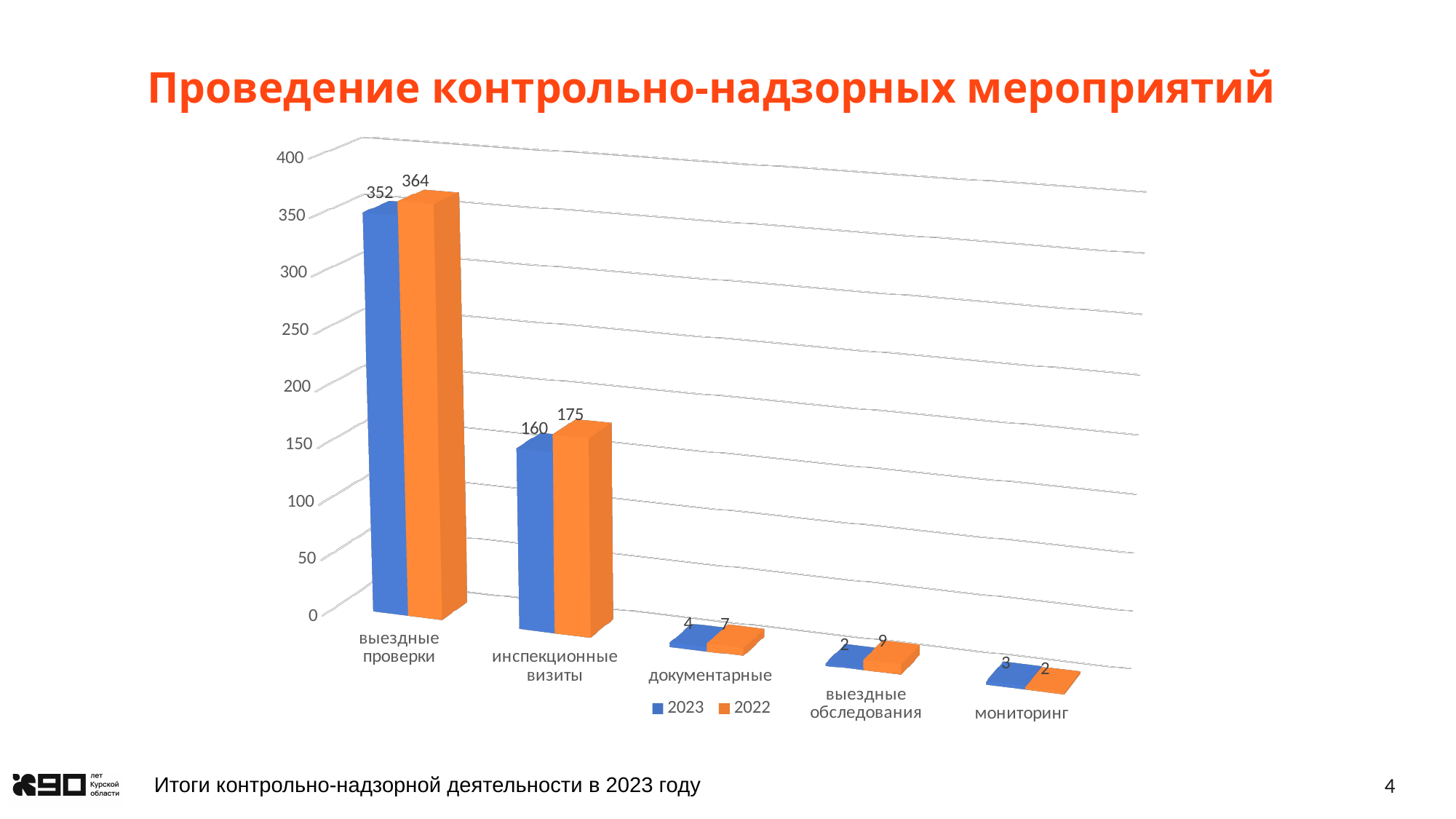
How many series does the legend list? 2 Which category has the lowest 2022 value? мониторинг What is the 2023 value for выездные проверки? 352 What is the 2023 value for мониторинг? 3 What kind of chart is shown on the slide? bar chart What is the 2022 value for выездные обследования? 9 How many categories are shown on the x axis? 5 Which category has the highest 2023 value? выездные проверки What is the 2022 value for инспекционные визиты? 175 What is the difference between the 2022 and 2023 values for выездные проверки? 12 For документарные, which year has the larger value, 2023 or 2022? 2022 What is the difference between the 2022 and 2023 values for инспекционные визиты? 15